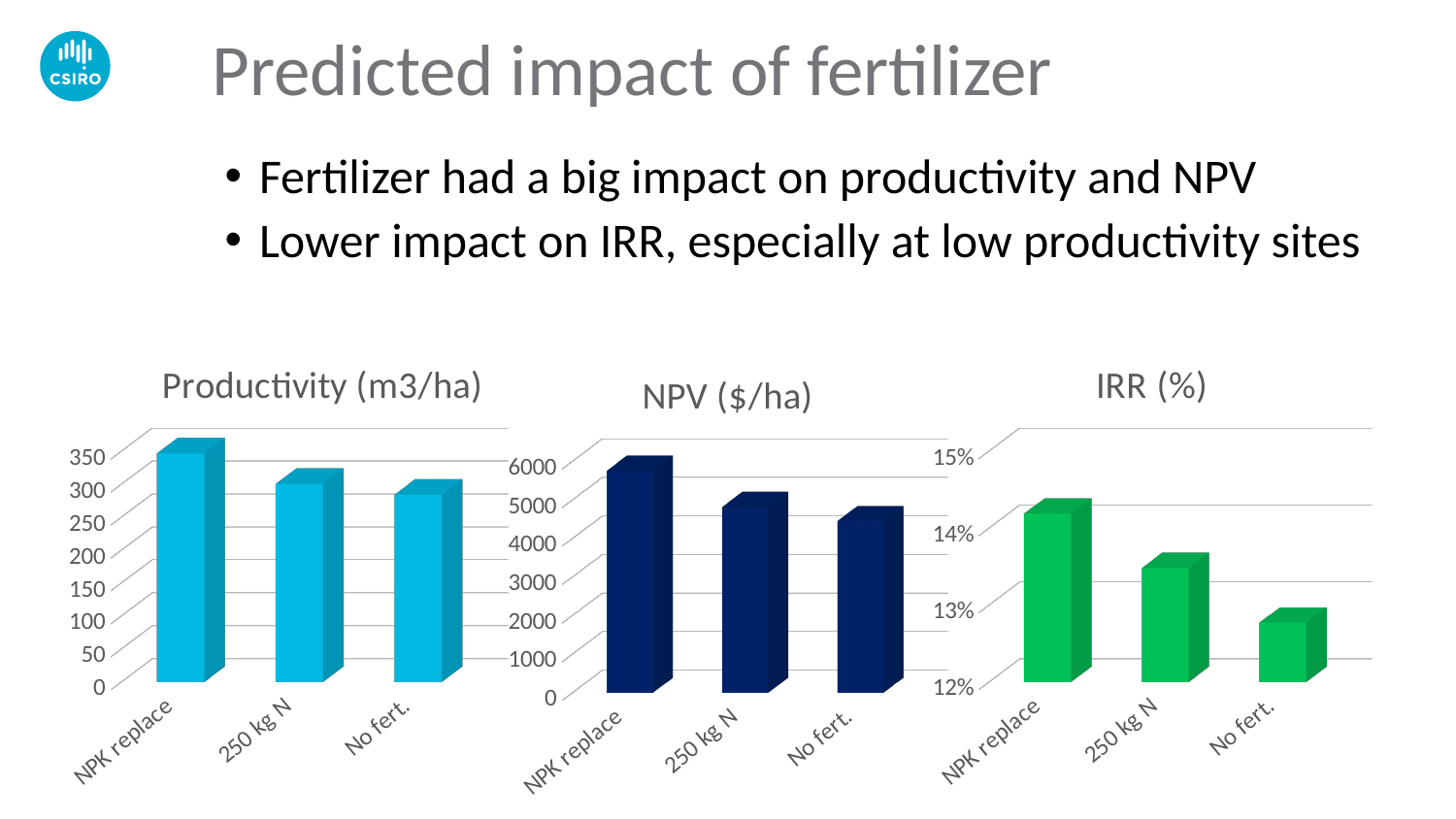
How many categories are shown in the NPV ($/ha) chart? 3 In the Productivity (m3/ha) chart, which category has the highest value? NPK replace In the NPV ($/ha) chart, do the values rise or fall from NPK replace to No fert.? fall In the IRR (%) chart, which is larger, the value for 250 kg N or the value for No fert.? 250 kg N In the NPV ($/ha) chart, is the value for No fert. greater or less than 5000? less In the NPV ($/ha) chart, which category has the lowest value? No fert. What kind of chart is the IRR (%) chart? bar chart In the Productivity (m3/ha) chart, is the value for NPK replace greater or less than 300? greater In the IRR (%) chart, is the value for 250 kg N greater or less than 13%? greater In the IRR (%) chart, which category has the highest value? NPK replace